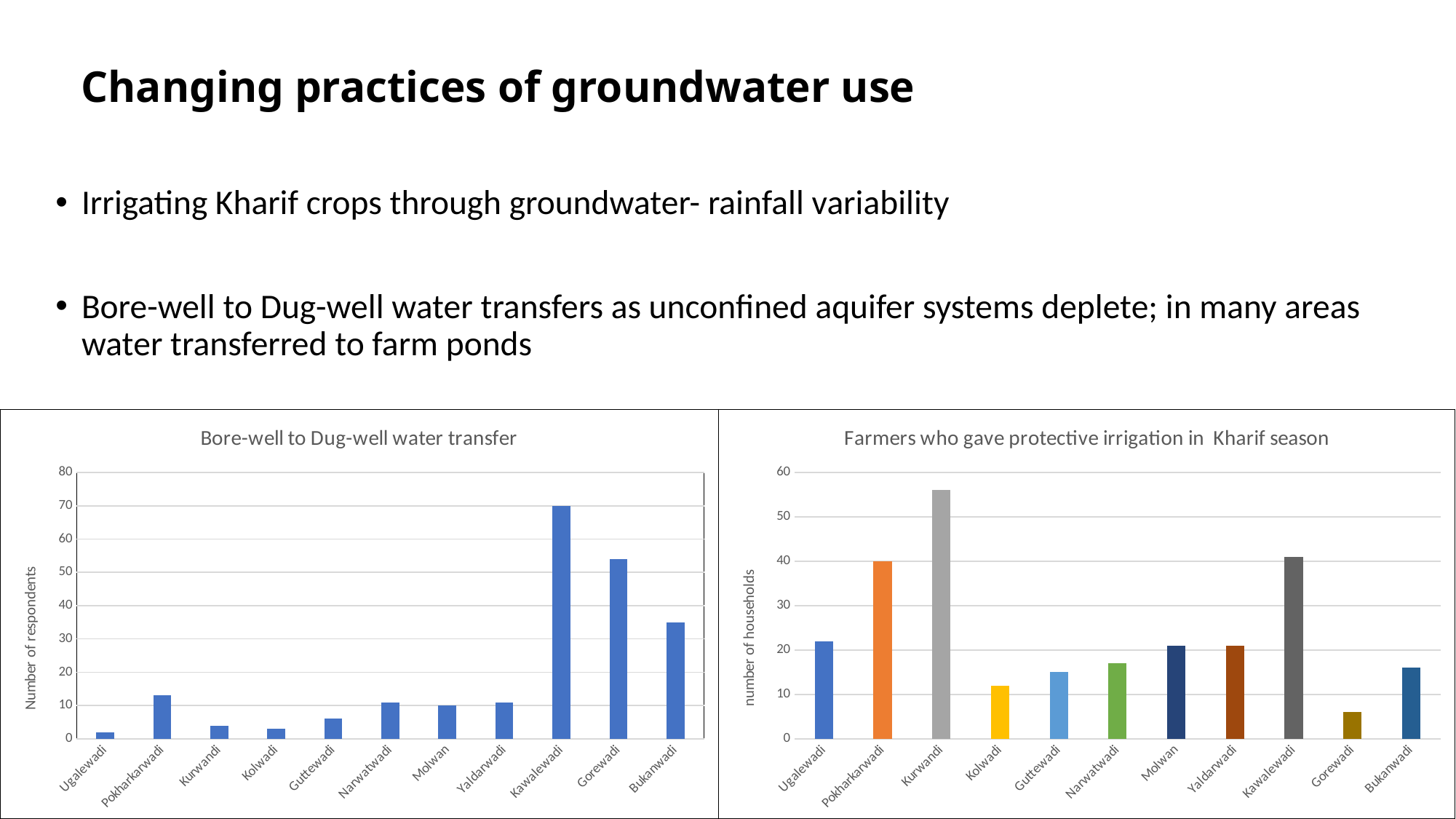
In the 'Bore-well to Dug-well water transfer' chart, which village has the highest number of respondents? Kawalewadi How many villages are shown on the x axis of the 'Bore-well to Dug-well water transfer' chart? 11 In the 'Farmers who gave protective irrigation in Kharif season' chart, which village has the highest number of households? Kurwandi In the 'Bore-well to Dug-well water transfer' chart, which is larger, the value for Gorewadi or the value for Bukanwadi? Gorewadi In the 'Bore-well to Dug-well water transfer' chart, is the value for Bukanwadi greater or less than 40? less What type of chart is the 'Bore-well to Dug-well water transfer' chart? bar chart In the 'Farmers who gave protective irrigation in Kharif season' chart, which village has the lowest number of households? Gorewadi In the 'Farmers who gave protective irrigation in Kharif season' chart, what is the number of households for Pokharkarwadi? 40 In the 'Farmers who gave protective irrigation in Kharif season' chart, is the value for Kurwandi greater or less than 50? greater What is the y-axis label of the 'Farmers who gave protective irrigation in Kharif season' chart? number of households In the 'Bore-well to Dug-well water transfer' chart, is the value for Gorewadi greater or less than 50? greater In the 'Farmers who gave protective irrigation in Kharif season' chart, which is larger, the value for Kurwandi or the value for Kawalewadi? Kurwandi